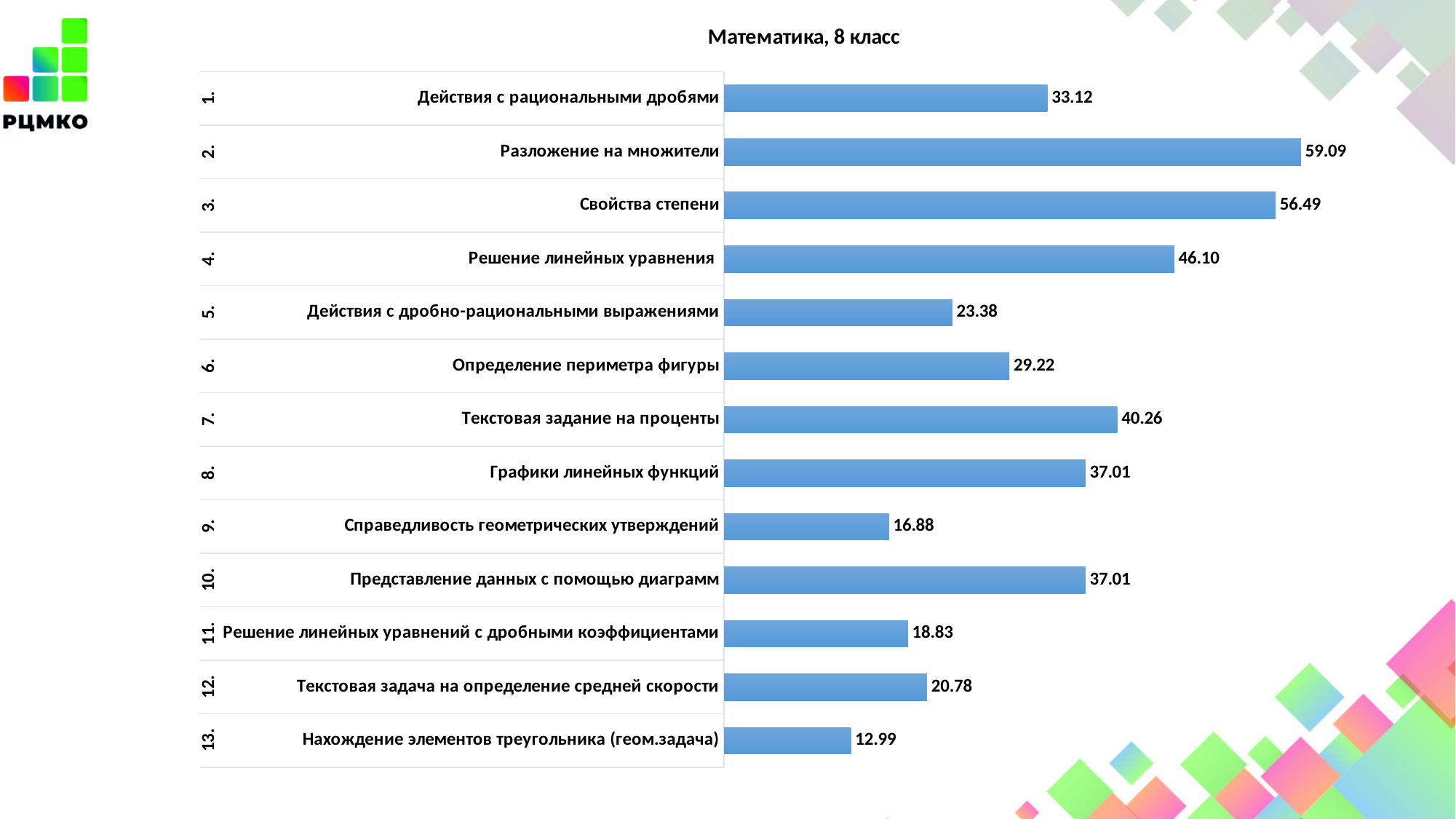
What is the value for "Справедливость геометрических утверждений"? 16.88 Which category has the lowest value? Нахождение элементов треугольника (геом.задача) How many categories are shown in the chart? 13 What is the value for "Действия с дробно-рациональными выражениями"? 23.38 What is the value for "Текстовая задание на проценты"? 40.26 What is the value for "Разложение на множители"? 59.09 What is the title of the chart? Математика, 8 класс What is the difference between the values for "Разложение на множители" and "Нахождение элементов треугольника (геом.задача)"? 46.10 Which category has the highest value? Разложение на множители What kind of chart is shown on the slide? Bar chart Which is larger: the value for "Действия с рациональными дробями" or the value for "Определение периметра фигуры"? Действия с рациональными дробями What is the difference between the values for "Свойства степени" and "Решение линейных уравнения"? 10.39